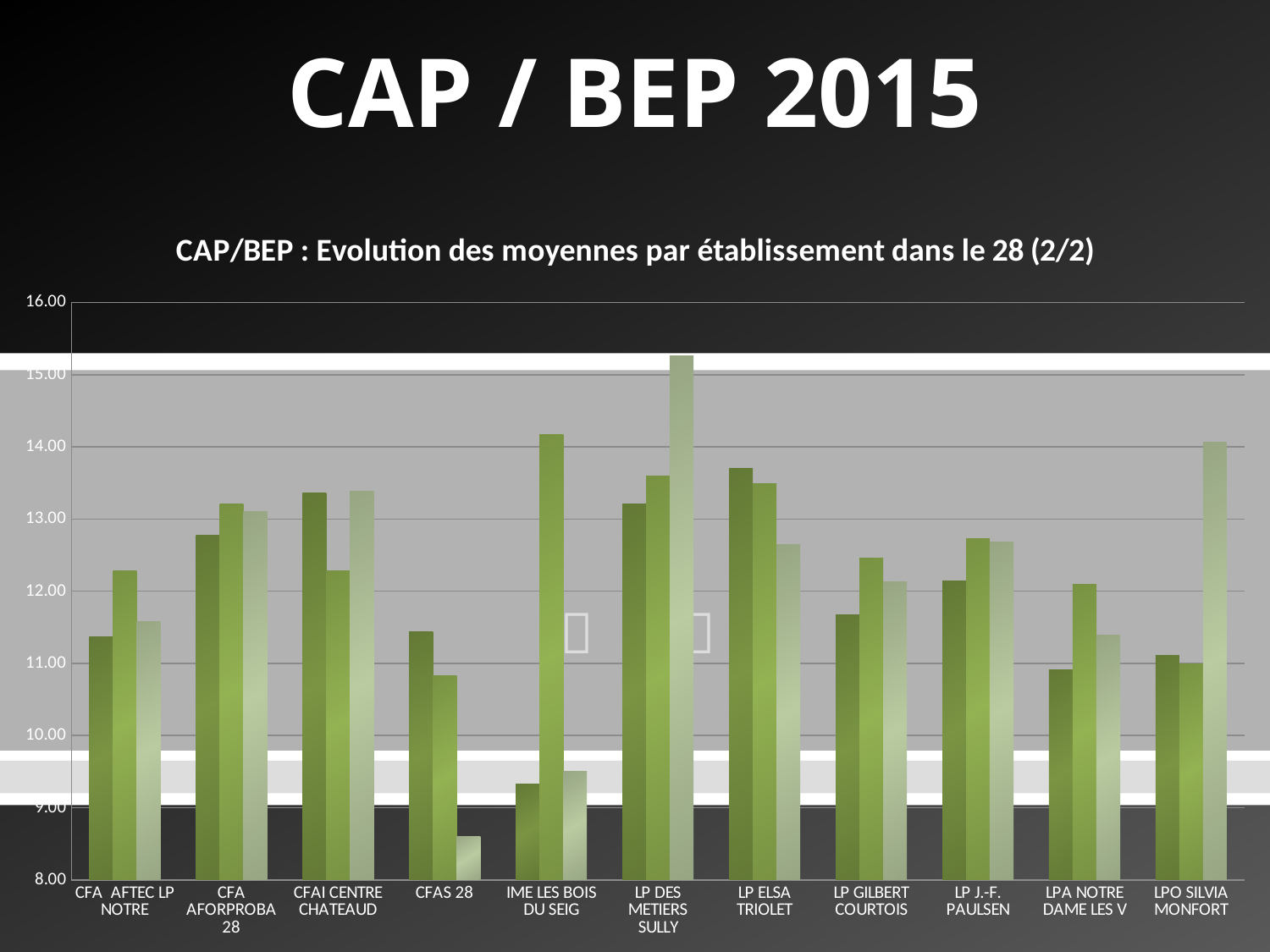
What kind of chart is shown on the slide? bar chart What is the title of the chart? CAP/BEP : Evolution des moyennes par établissement dans le 28 (2/2) Which establishment has the tallest bar in the chart? LP DES METIERS SULLY Is the value of the shortest bar for CFAS 28 greater or less than 9.00? less Is the value of the first (leftmost) bar for IME LES BOIS DU SEIG greater or less than 10.00? less Which is larger: the first (leftmost) bar for LP ELSA TRIOLET or the first (leftmost) bar for CFAS 28? LP ELSA TRIOLET How many bars are plotted for each establishment in the chart? 3 How many establishments (categories) are shown on the x axis of the chart? 11 Is the value of the tallest bar for LP DES METIERS SULLY greater or less than 15.00? greater Which establishment has the shortest bar in the chart? CFAS 28